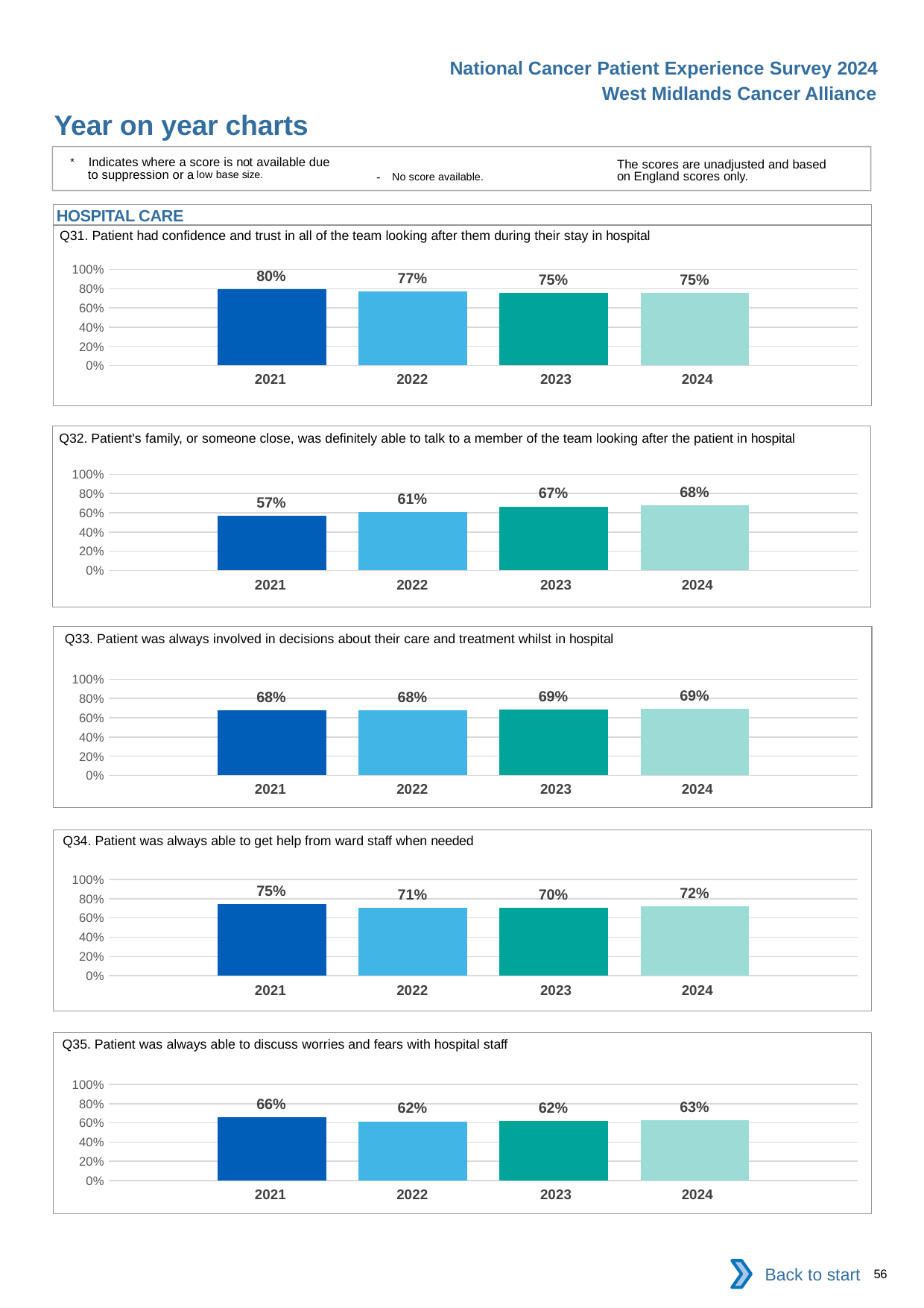
In the Q33 chart, how many years are plotted? 4 In the Q31 chart, do the values rise or fall from 2021 to 2024? fall In the Q32 chart, which year has the lowest value? 2021 In the Q32 chart, what is the difference between the 2024 and 2021 values? 11% In the Q35 chart, what is the value for 2024? 63% What is the section heading above the Q31 chart? HOSPITAL CARE In the Q35 chart, what is the difference between the 2021 and 2022 values? 4% What type of chart is used for Q35? bar chart In the Q32 chart, do the values rise or fall from 2021 to 2024? rise In the Q31 chart, what is the value for 2021? 80% In the Q34 chart, which year has the highest value? 2021 In the Q34 chart, is the value for 2023 larger or smaller than the value for 2024? smaller